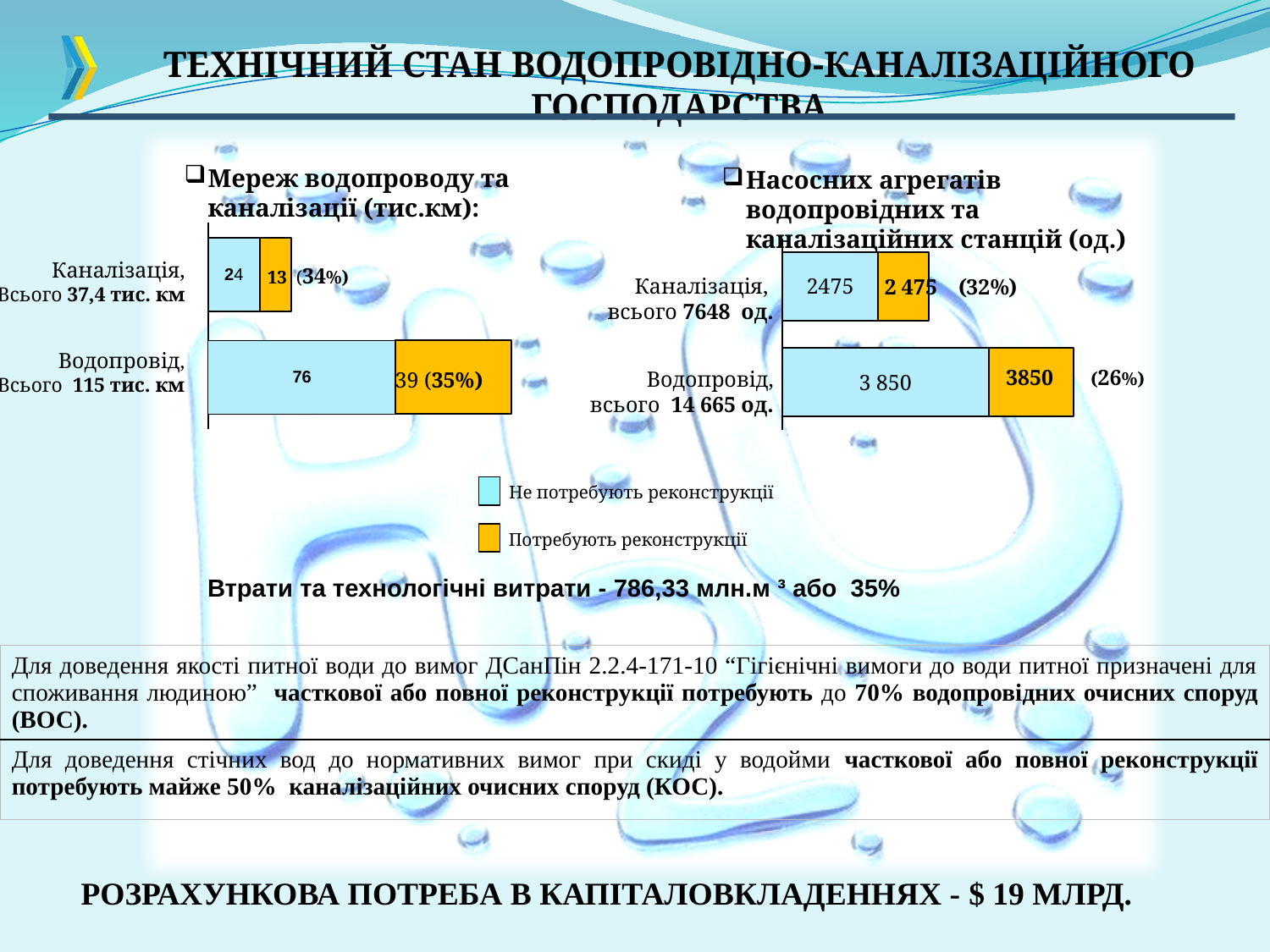
In the left chart (Мереж водопроводу та каналізації), what is the value of the 'Не потребують реконструкції' segment for Каналізація? 24 In the right chart (Насосних агрегатів), what total is given in the category label for Водопровід? 14 665 од. In the left chart (Мереж водопроводу та каналізації), which category has the larger 'Потребують реконструкції' value, Водопровід or Каналізація? Водопровід How many series does the shared legend list? 2 How many categories does the left chart (Мереж водопроводу та каналізації) show? 2 In the left chart (Мереж водопроводу та каналізації), what is the value of the 'Не потребують реконструкції' segment for Водопровід? 76 In the left chart (Мереж водопроводу та каналізації), what is the value of the 'Потребують реконструкції' segment for Каналізація? 13 (34%) In the left chart (Мереж водопроводу та каналізації), what is the difference between the 'Не потребують реконструкції' values for Водопровід and Каналізація? 52 In the right chart (Насосних агрегатів), what percentage is shown next to the Каналізація bar? 32% In the left chart (Мереж водопроводу та каналізації), what is the value of the 'Потребують реконструкції' segment for Водопровід? 39 (35%) What type of chart is the right chart (Насосних агрегатів)? Stacked bar chart In the right chart (Насосних агрегатів), what percentage is shown next to the Водопровід bar? 26%